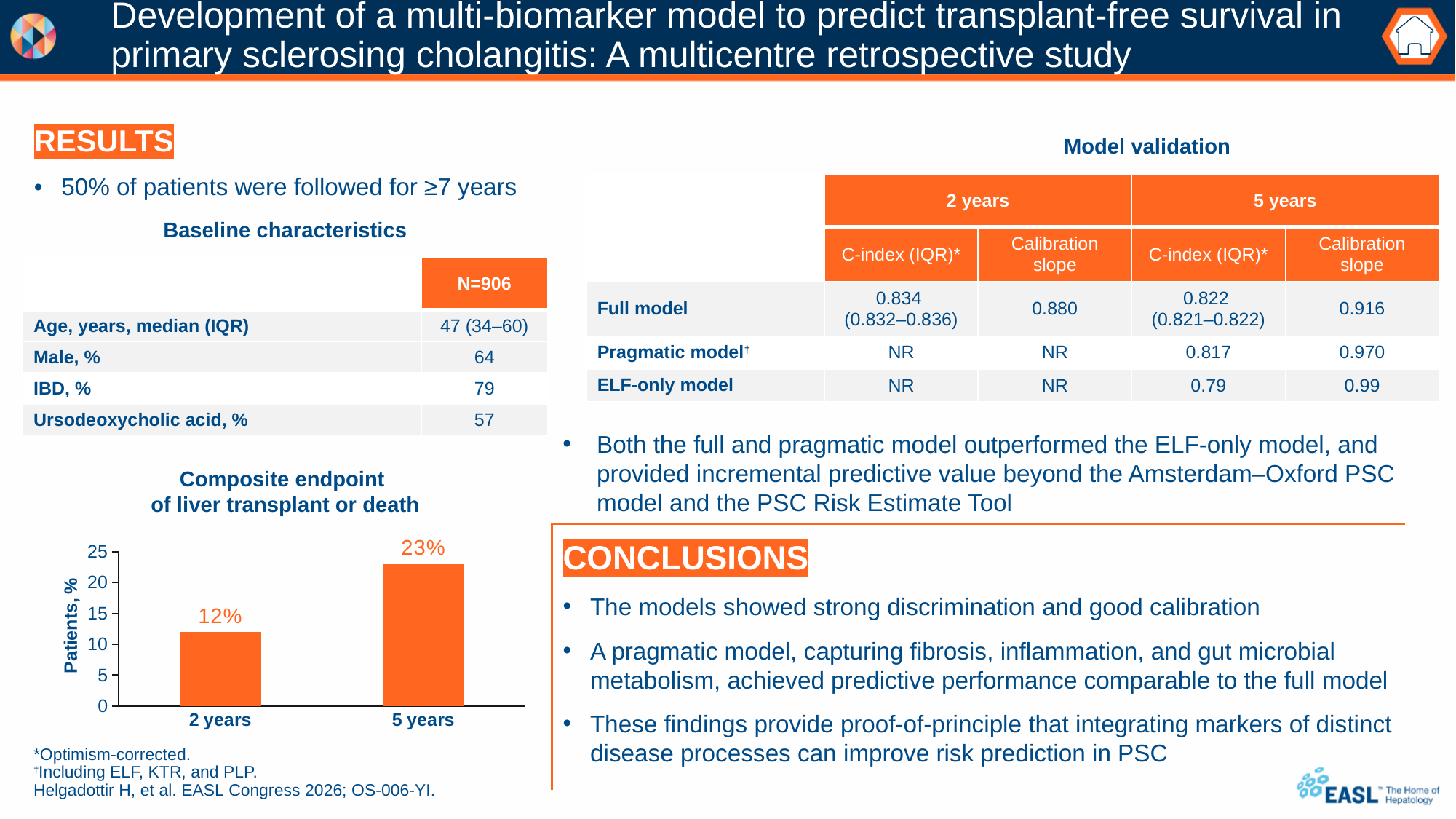
In the Composite endpoint chart, is the value for 2 years greater or less than 15? less What is the y-axis label of the Composite endpoint chart? Patients, % Which category has the highest value in the Composite endpoint chart? 5 years Which category has the lowest value in the Composite endpoint chart? 2 years What is the value for 5 years in the Composite endpoint of liver transplant or death chart? 23% What is the value for 2 years in the Composite endpoint of liver transplant or death chart? 12% In the Composite endpoint chart, is the value for 2 years or 5 years larger? 5 years What is the difference between the 5 years and 2 years values in the Composite endpoint chart? 11% What type of chart is the Composite endpoint of liver transplant or death chart? Bar chart How many categories are shown on the x axis of the Composite endpoint chart? 2 Do the values in the Composite endpoint chart rise or fall from 2 years to 5 years? Rise In the Composite endpoint chart, is the value for 5 years greater or less than 20? greater